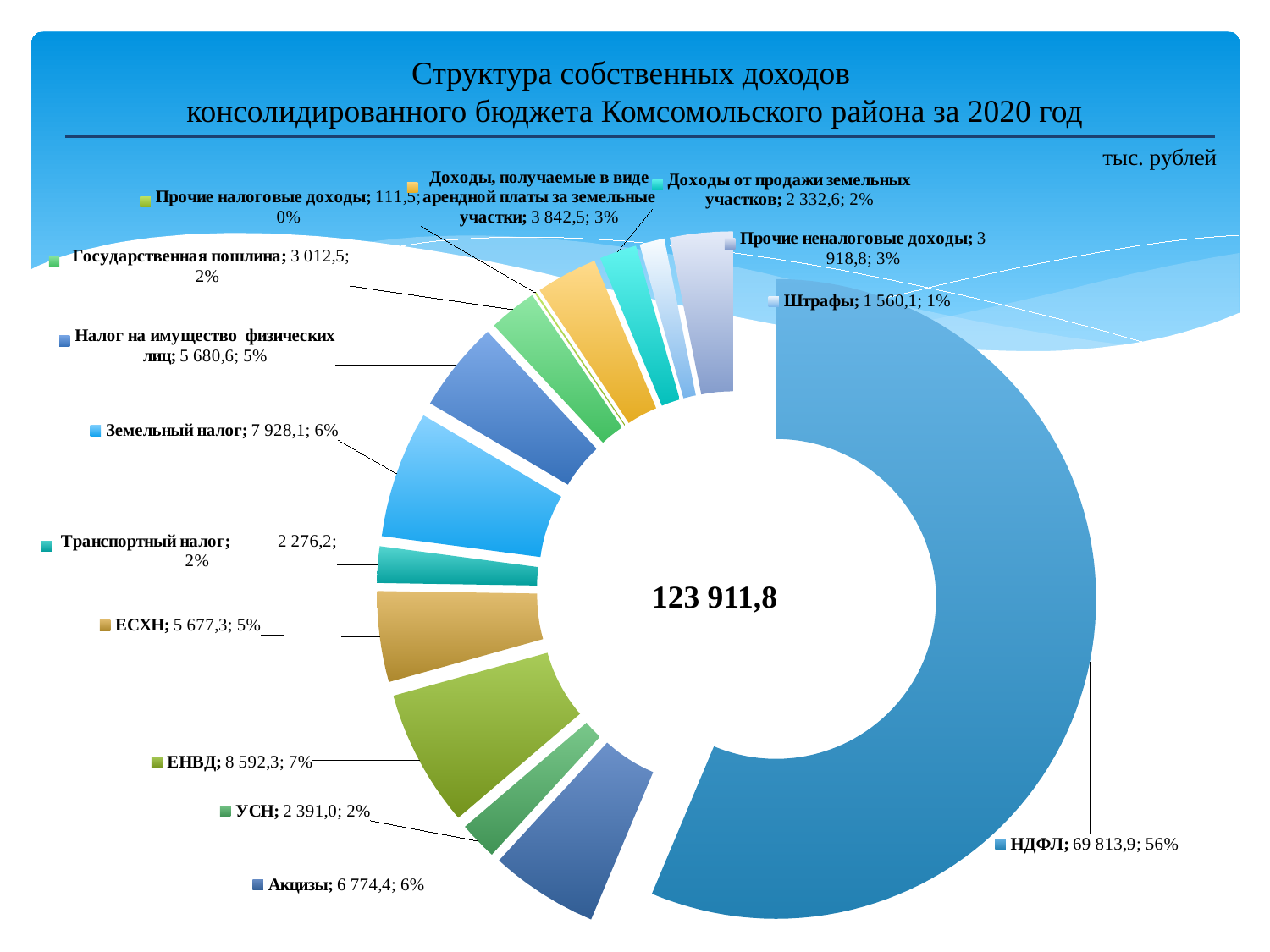
What kind of chart is shown on the slide? doughnut chart Which category has the smallest value? Прочие налоговые доходы What share of the total does НДФЛ represent? 56% Which category has the largest value? НДФЛ Which is larger, the value for ЕСХН or the value for Налог на имущество физических лиц? Налог на имущество физических лиц What is the difference between the values for ЕНВД and Акцизы? 1 817,9 What share of the total does Штрафы represent? 1% What is the value for Земельный налог? 7 928,1 What is the value for НДФЛ? 69 813,9 What total value is shown in the centre of the chart? 123 911,8 How many categories are shown in the chart? 14 What is the value for ЕНВД? 8 592,3